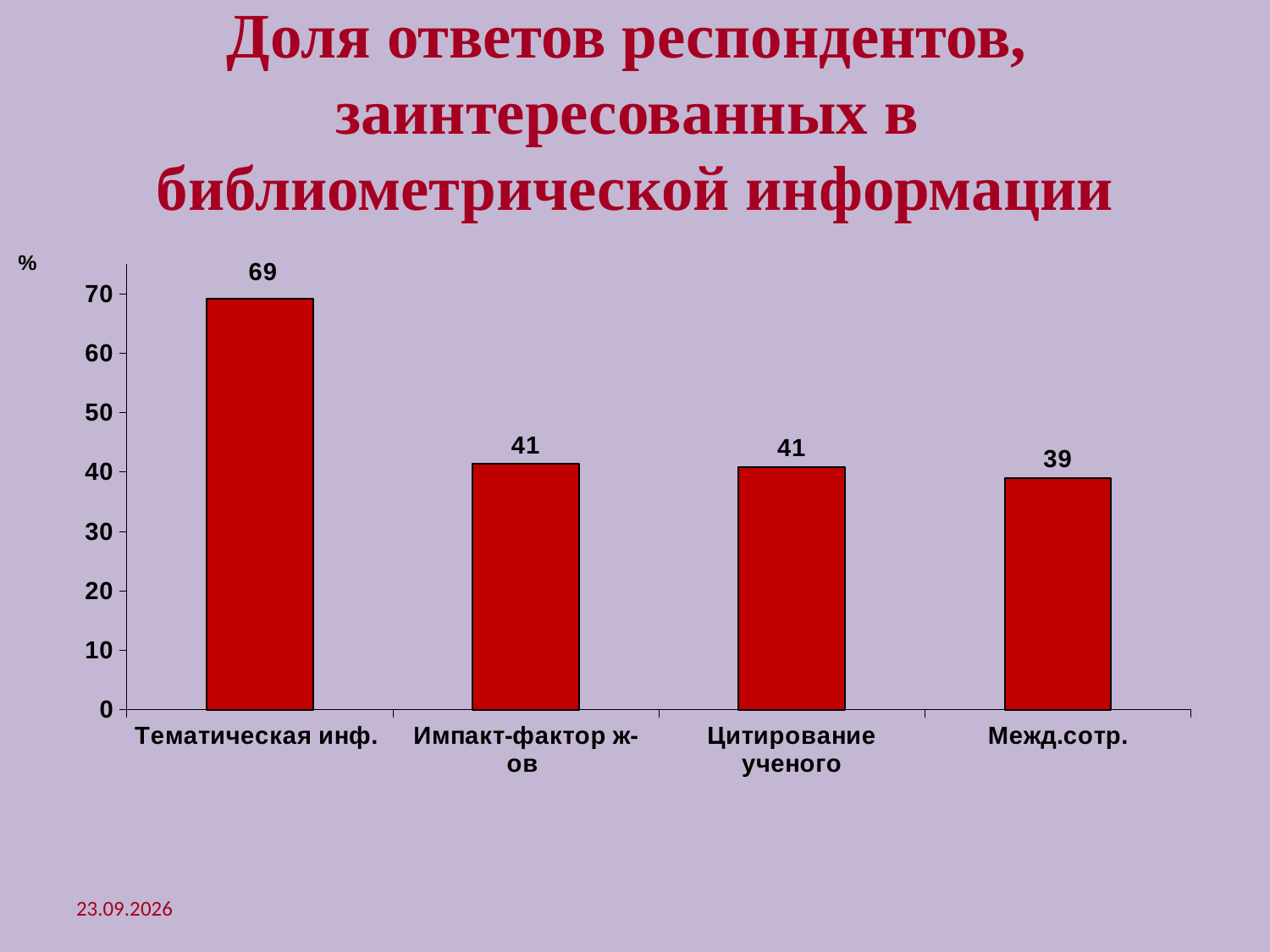
Which category has the highest value? Тематическая инф. What is the value for Межд.сотр.? 39 How many categories are shown on the chart? 4 Which category has the lowest value? Межд.сотр. What kind of chart is shown on the slide? bar chart What unit is shown on the vertical axis label? % What is the value for Тематическая инф.? 69 What is the value for Цитирование ученого? 41 What is the difference between the values for Тематическая инф. and Импакт-фактор ж-ов? 28 Is the value for Импакт-фактор ж-ов greater or less than 50? less Which is larger, the value for Тематическая инф. or the value for Межд.сотр.? Тематическая инф. What is the difference between the values for Цитирование ученого and Межд.сотр.? 2